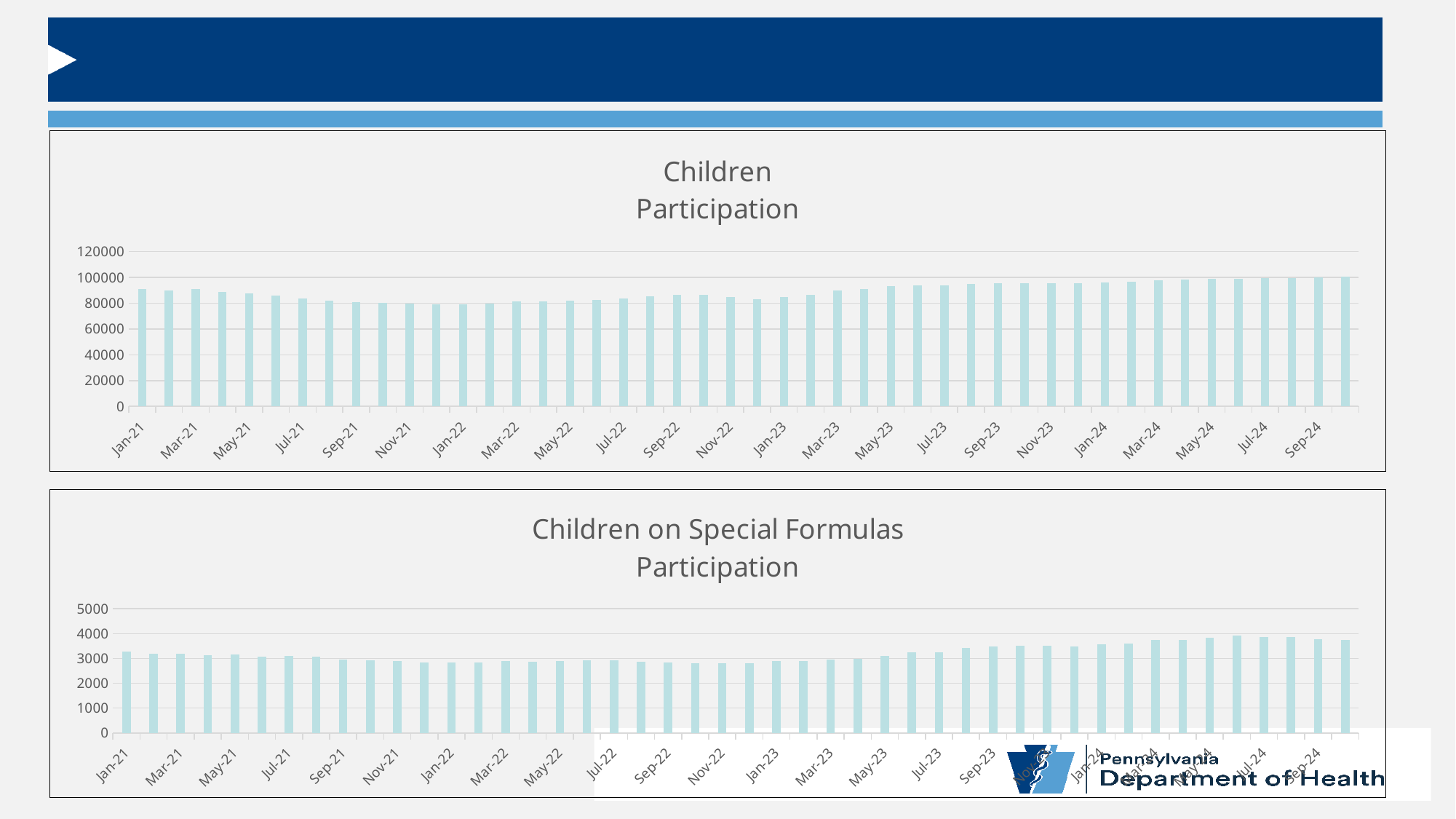
In the 'Children Participation' chart, which is larger, the value for Jan-21 or the value for Jan-22? Jan-21 In the 'Children Participation' chart, do the values generally rise or fall from Jan-23 to Sep-24? rise In the 'Children Participation' chart, which is larger, the value for Sep-21 or the value for Sep-24? Sep-24 In the 'Children on Special Formulas Participation' chart, is the value for Jan-21 greater or less than 3000? greater What is the title of the lower chart on the slide? Children on Special Formulas Participation In the 'Children on Special Formulas Participation' chart, is the value for Nov-22 greater or less than 3000? less In the 'Children on Special Formulas Participation' chart, is the value for Sep-24 greater or less than 3000? greater In the 'Children on Special Formulas Participation' chart, which is larger, the value for Jul-21 or the value for Jul-24? Jul-24 What type of chart is the 'Children on Special Formulas Participation' chart? bar chart What type of chart is the 'Children Participation' chart? bar chart